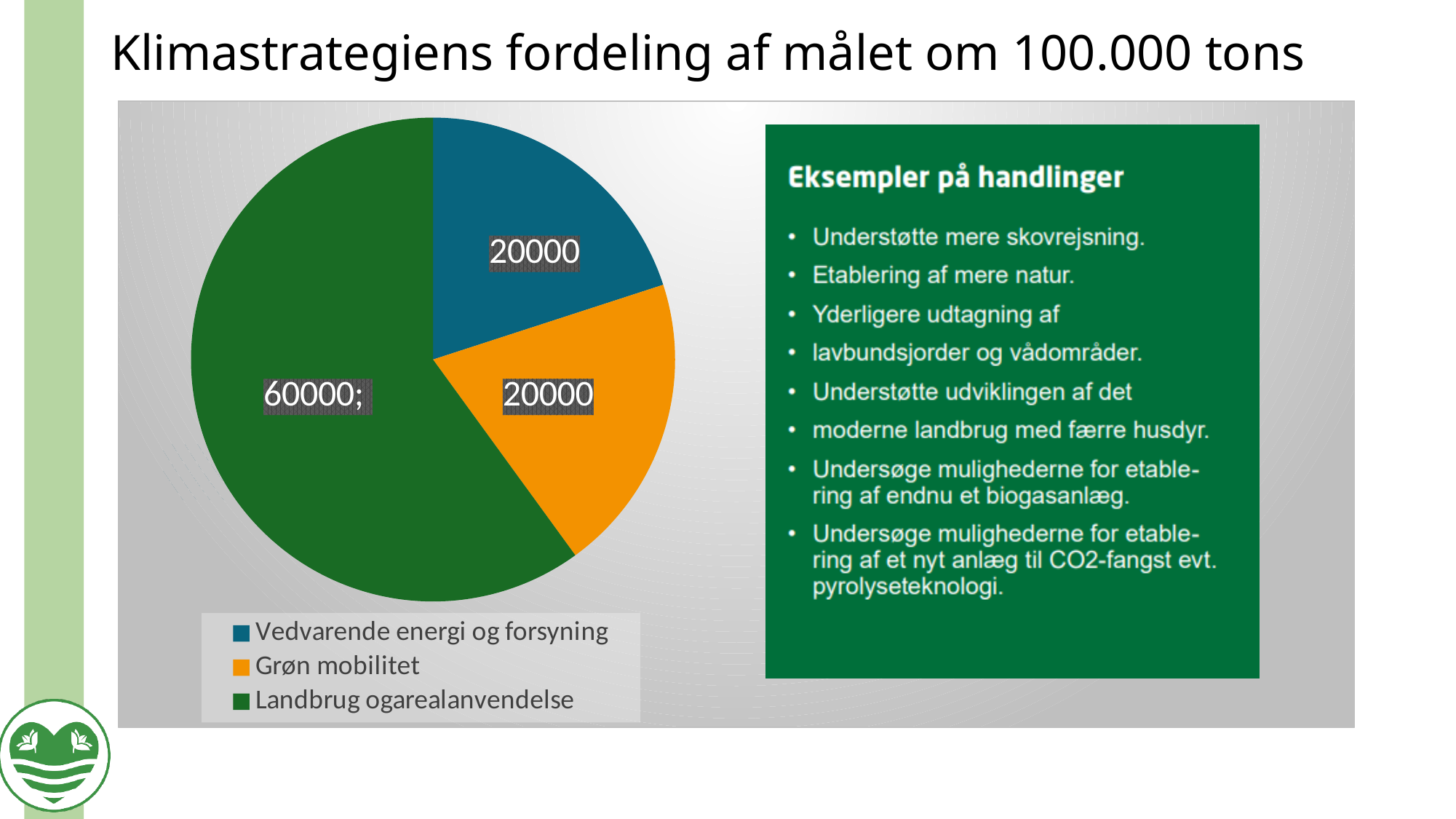
What is the value for Grøn mobilitet? 20000 Which colour represents Grøn mobilitet in the pie chart? orange Which is larger, the value for Landbrug ogarealanvendelse or the value for Grøn mobilitet? Landbrug ogarealanvendelse What is the total of all slices in the pie chart? 100000 What is the value for Landbrug ogarealanvendelse? 60000 Which category has the largest slice of the pie? Landbrug ogarealanvendelse What is the difference between the value for Landbrug ogarealanvendelse and the value for Vedvarende energi og forsyning? 40000 How many categories does the pie chart have? 3 What kind of chart is shown on the slide? pie chart What share of the pie does Landbrug ogarealanvendelse represent? 60% What share of the pie does Grøn mobilitet represent? 20% What is the value for Vedvarende energi og forsyning? 20000